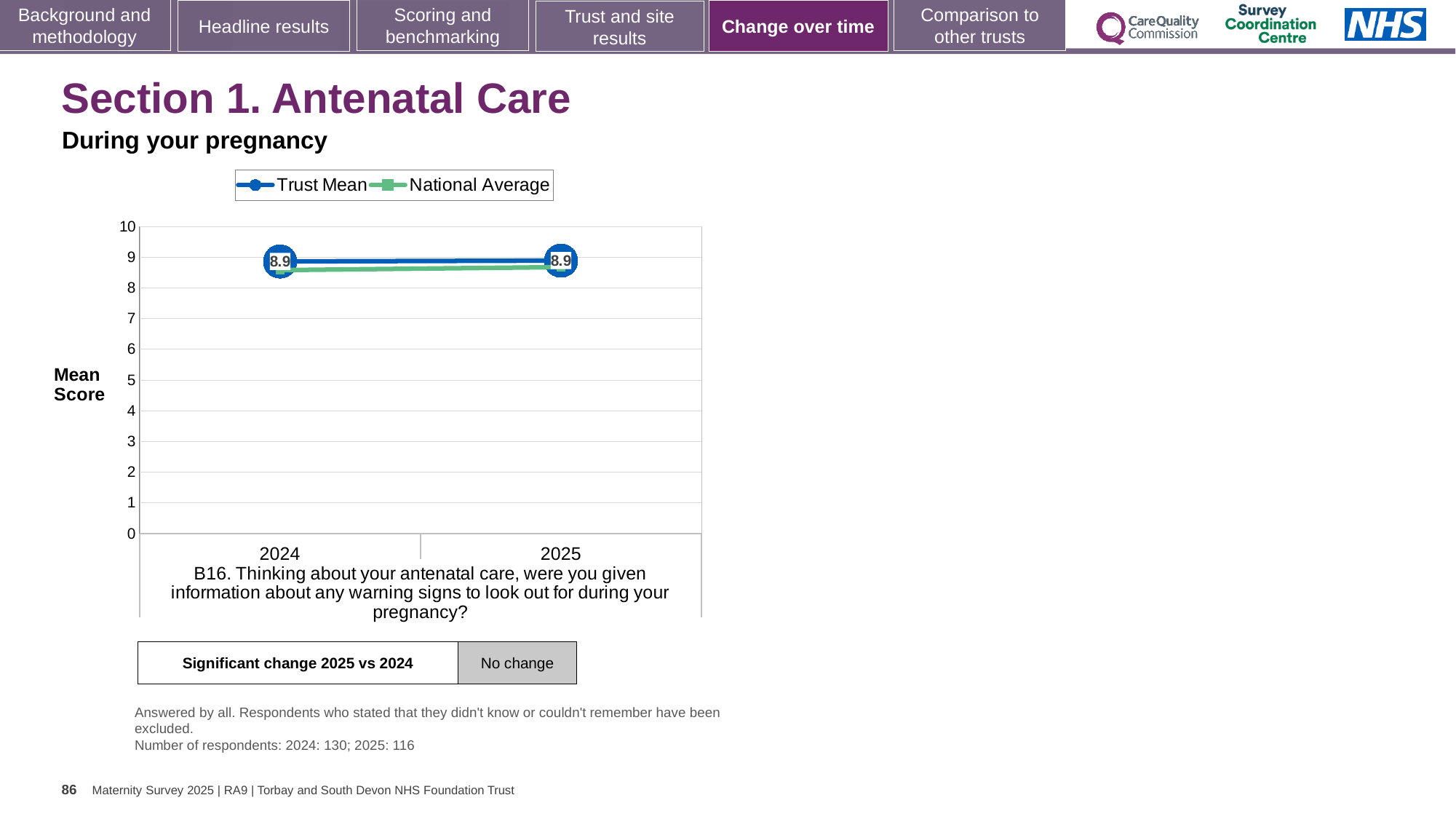
What is the Trust Mean score for 2024? 8.9 How many series does the chart legend list? 2 Is the National Average value for 2024 greater or less than 8? greater Is the National Average value for 2025 greater or less than 9? less In 2024, which is higher: the Trust Mean or the National Average? Trust Mean How many years are shown on the x axis of the chart? 2 What is the difference between the Trust Mean score in 2025 and in 2024? 0 What kind of chart is shown on the slide? line chart What colour is the National Average line in the chart? green What is the Trust Mean score for 2025? 8.9 Does the Trust Mean rise, fall or stay the same from 2024 to 2025? stays the same What is the label of the y axis of the chart? Mean Score